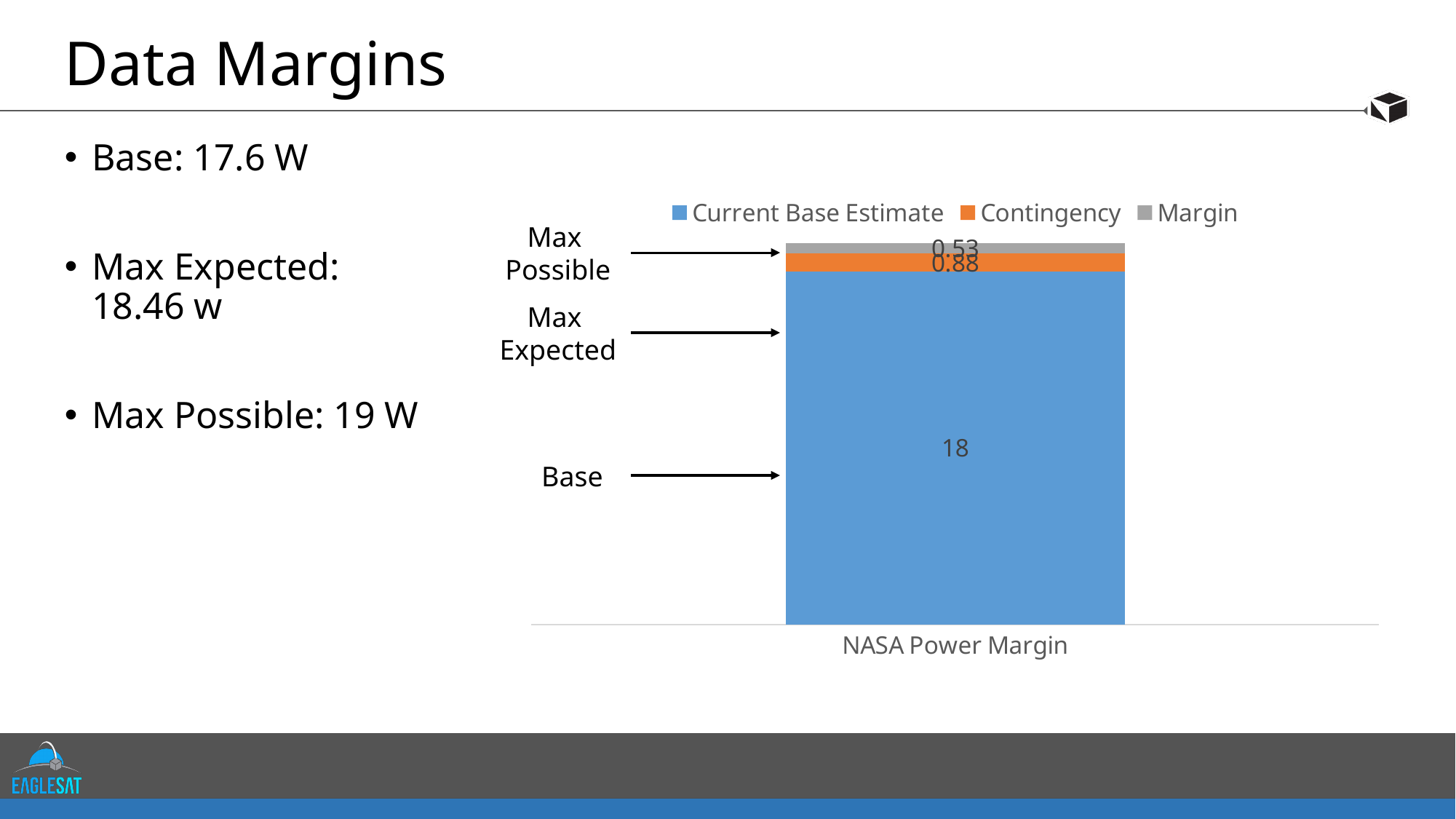
What is the difference between the Current Base Estimate value and the Contingency value? 17.12 What is the value of the Contingency segment in the NASA Power Margin bar? 0.88 What is the value of the Current Base Estimate segment in the NASA Power Margin bar? 18 What is the category label on the x axis of the chart? NASA Power Margin Which series has the largest segment in the NASA Power Margin bar? Current Base Estimate What is the value of the Margin segment in the NASA Power Margin bar? 0.53 What is the difference between the Contingency value and the Margin value? 0.35 How many series does the chart legend list? 3 How many categories are shown on the x axis of the chart? 1 What type of chart is shown on the slide? Stacked bar chart Is the Contingency segment larger or smaller than the Margin segment? Larger Which series has the smallest segment in the NASA Power Margin bar? Margin